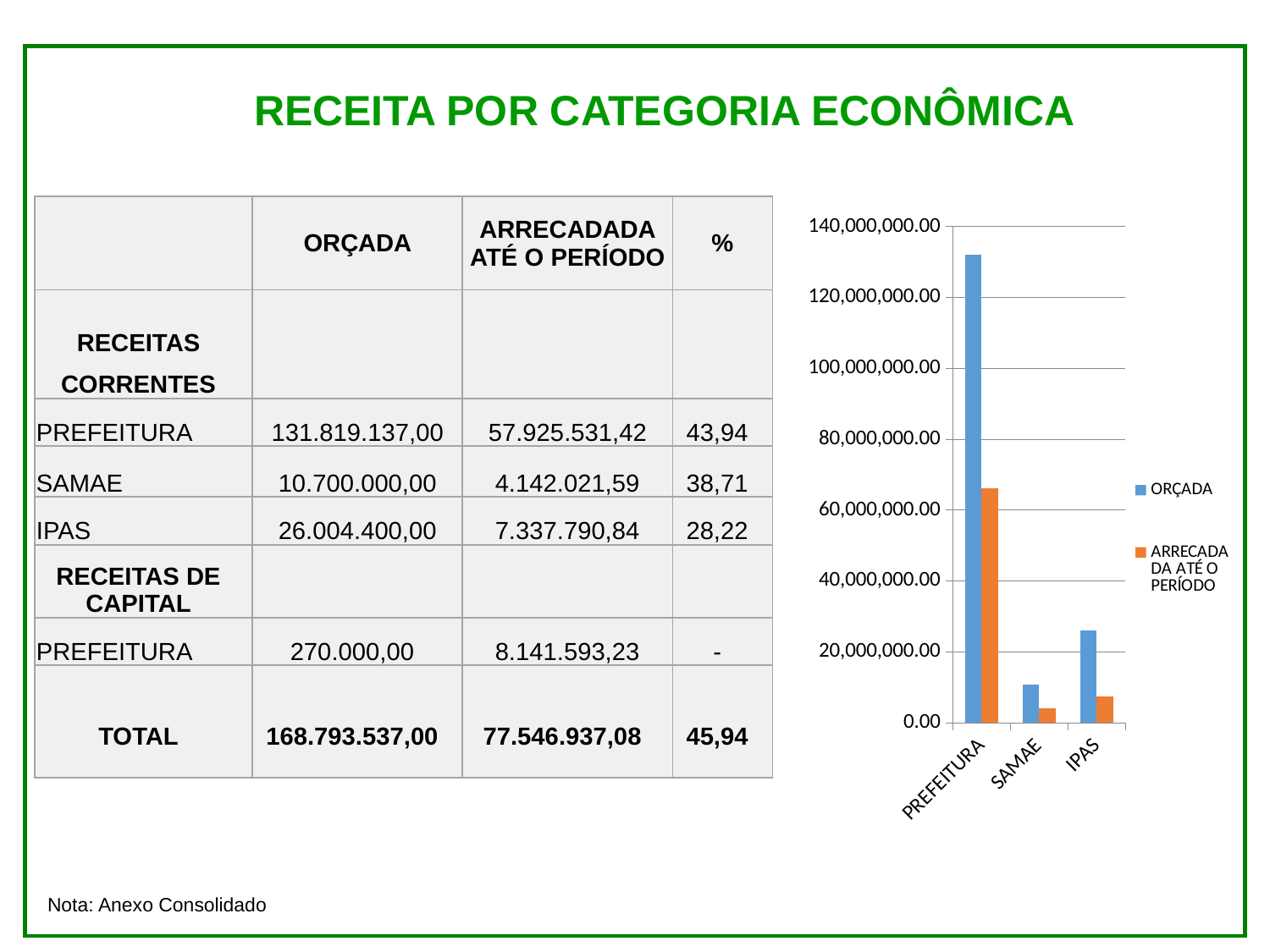
Is the ORÇADA value for PREFEITURA greater or less than 120,000,000.00? greater Is the ORÇADA value for IPAS greater or less than 20,000,000.00? greater Which has the larger ORÇADA bar, SAMAE or IPAS? IPAS What kind of chart is shown on the slide? bar chart What colour are the ORÇADA bars in the chart? blue Which category has the lowest ORÇADA bar in the chart? SAMAE Which category has the highest ORÇADA bar in the chart? PREFEITURA How many categories are shown on the x axis of the chart? 3 How many series does the chart legend list? 2 Which category has the lowest ARRECADADA ATÉ O PERÍODO bar in the chart? SAMAE Is the ARRECADADA ATÉ O PERÍODO value for PREFEITURA greater or less than 80,000,000.00? less